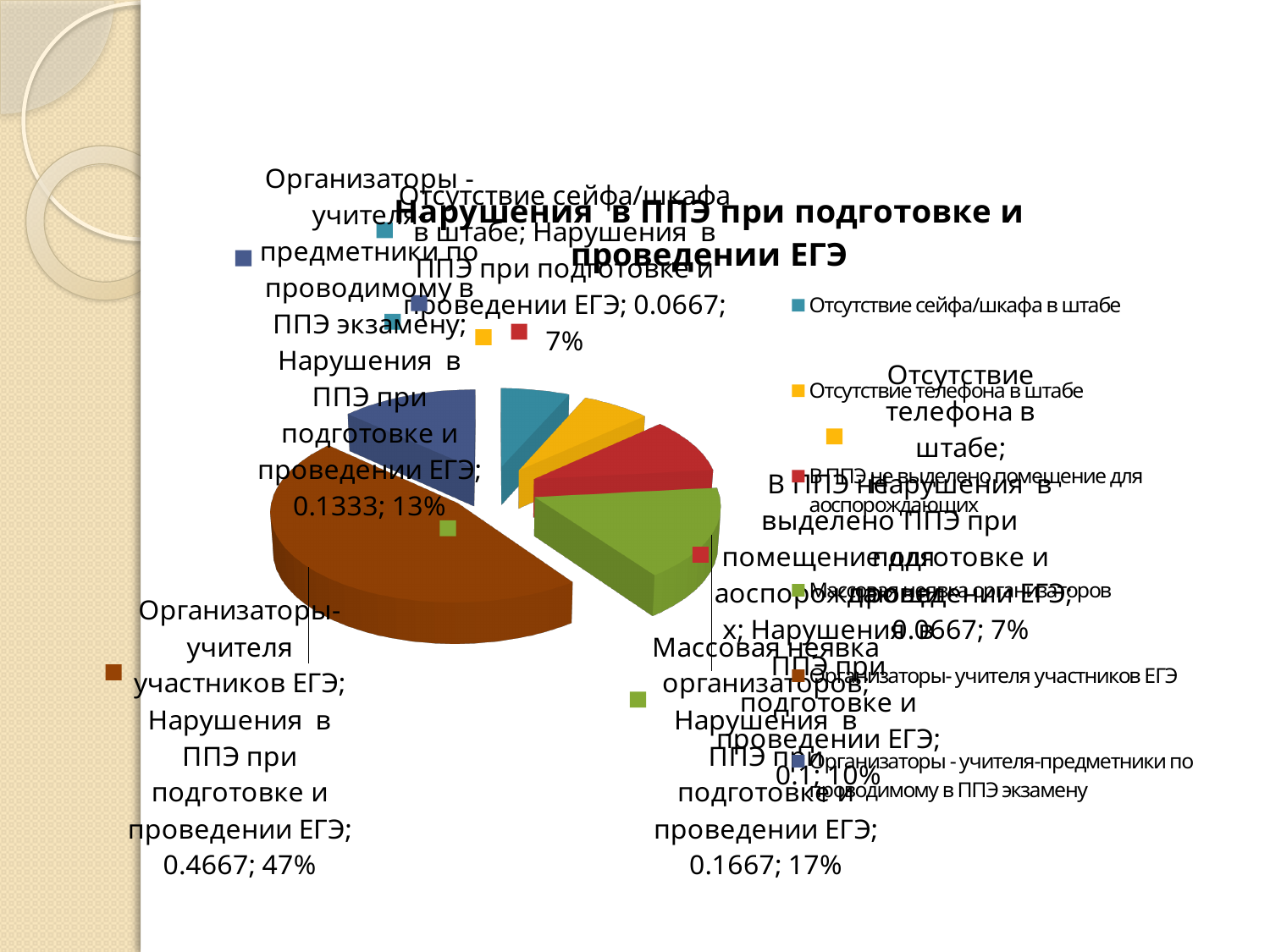
What percentage share is shown for 'Массовая неявка организаторов'? 17% Which category has the largest share of the pie? Организаторы-учителя участников ЕГЭ What percentage share is shown for 'Организаторы - учителя-предметники по проводимому в ППЭ экзамену'? 13% How many slices does the pie chart have? 6 What decimal value is labelled for 'Организаторы-учителя участников ЕГЭ'? 0.4667 How many entries does the legend list? 6 What is the title of the chart? Нарушения в ППЭ при подготовке и проведении ЕГЭ What percentage share is shown for 'Отсутствие сейфа/шкафа в штабе'? 7% What kind of chart is shown on the slide? Pie chart Which is larger: the share for 'Организаторы-учителя участников ЕГЭ' or for 'Массовая неявка организаторов'? Организаторы-учителя участников ЕГЭ What is the difference in percentage points between the share for 'Организаторы-учителя участников ЕГЭ' (47%) and 'Организаторы - учителя-предметники по проводимому в ППЭ экзамену' (13%)? 34